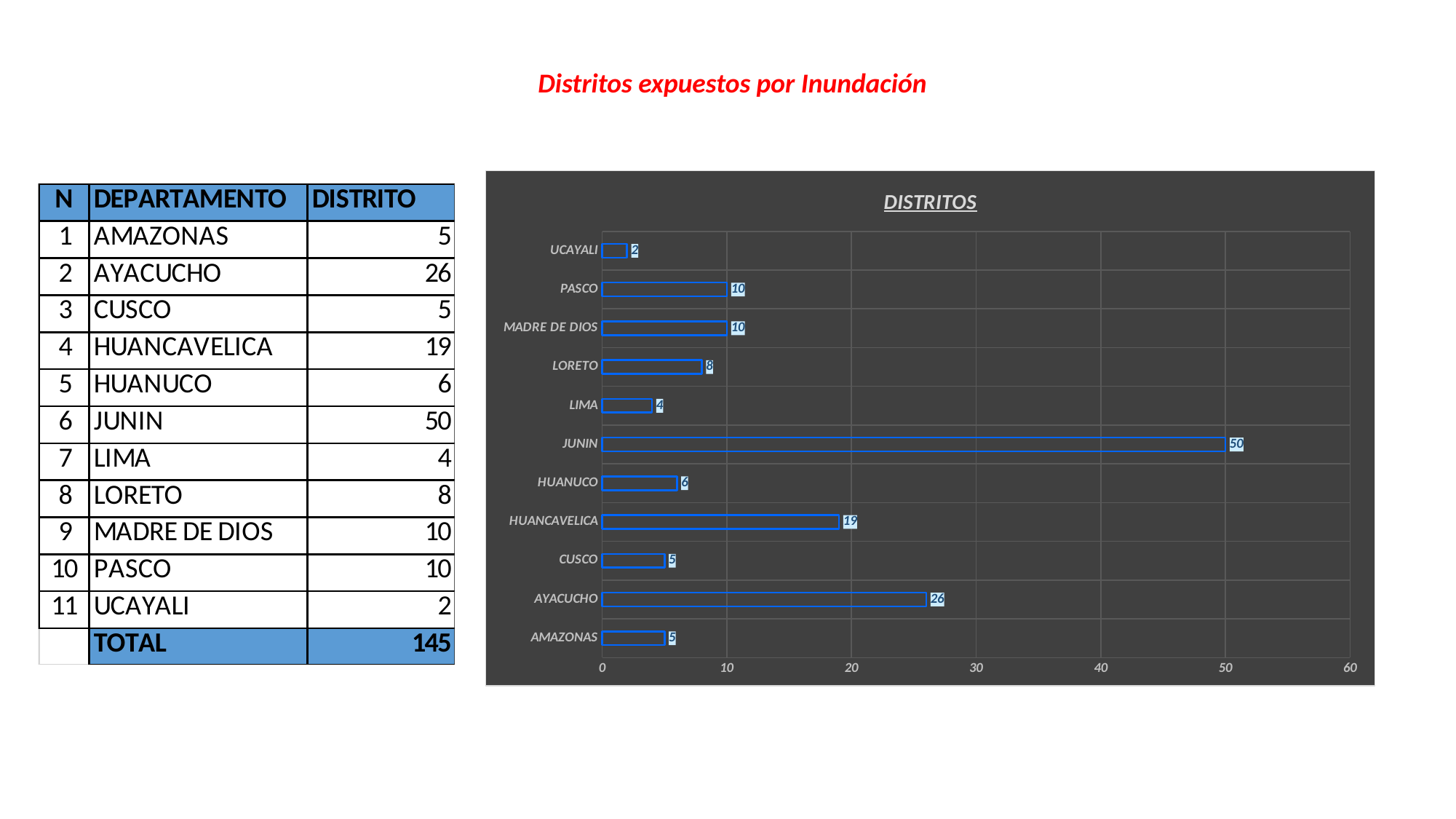
What is the value for LORETO in the DISTRITOS chart? 8 What is the value for HUANCAVELICA in the DISTRITOS chart? 19 What is the highest value shown on the x axis of the DISTRITOS chart? 60 Which department has the lowest value in the DISTRITOS chart? UCAYALI Is the value for AYACUCHO in the DISTRITOS chart greater or less than 20? greater Which has a larger value in the DISTRITOS chart, HUANCAVELICA or LORETO? HUANCAVELICA What kind of chart is the DISTRITOS chart? bar chart Which department has the highest value in the DISTRITOS chart? JUNIN What is the value for JUNIN in the DISTRITOS chart? 50 What is the difference between the values for JUNIN and AYACUCHO in the DISTRITOS chart? 24 What is the title of the chart on the slide? DISTRITOS How many departments are shown in the DISTRITOS chart? 11